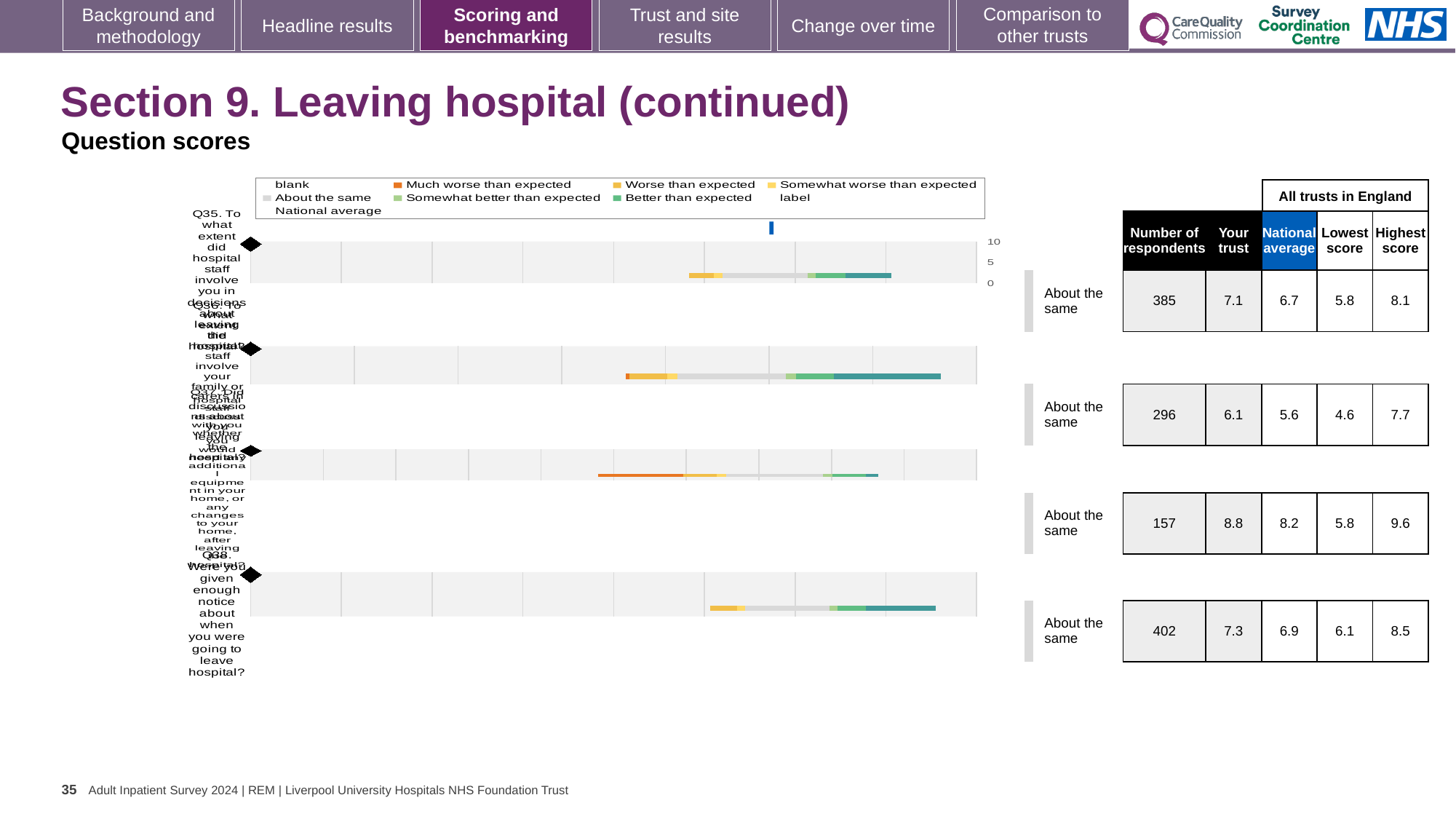
For Q38, what is the difference between the 'Your trust' score and the national average? 0.4 For Q38, what is the national average score? 6.9 For Q35 (To what extent did hospital staff involve you in decisions about leaving the hospital?), what is the 'Your trust' score? 7.1 For Q38 (Were you given enough notice about when you were going to leave hospital?), what is the 'Your trust' score? 7.3 Which of the four questions has the highest 'Your trust' score? the third question from the top (8.8) For Q35, which is larger: the 'Your trust' score or the national average? Your trust For the second question from the top, what is the highest score among all trusts in England? 7.7 What kind of chart is used to show the question scores on this slide? bar chart What benchmark category is shown next to the Q38 chart? About the same How many question charts are shown on the slide? 4 For Q38, how many respondents are there? 402 Which of the four questions has the lowest number of respondents? the third question from the top (157)